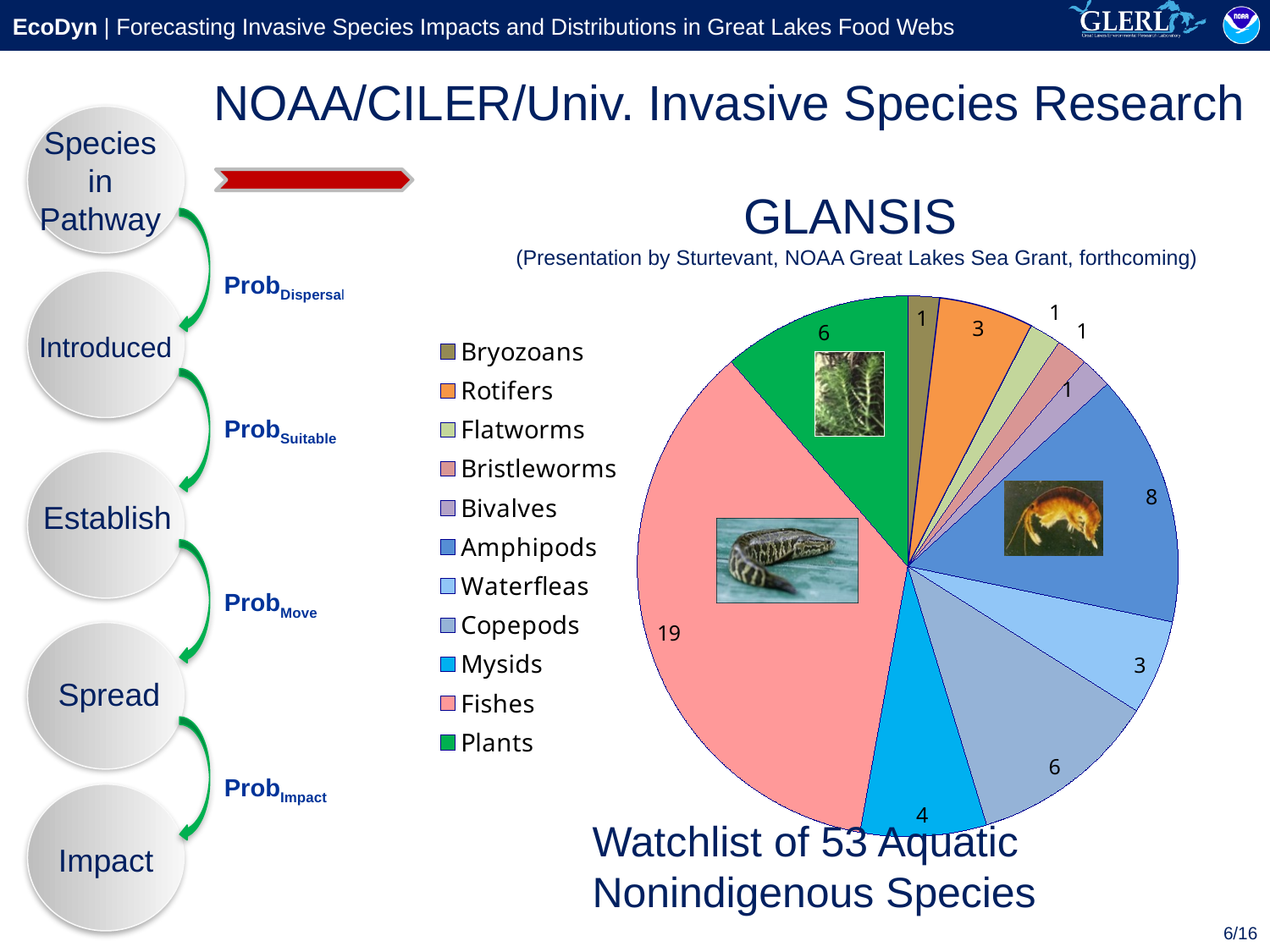
Which legend entry is shown in green in the pie chart? Plants What is the value for Amphipods in the pie chart? 8 What is the total number of species represented across all slices of the pie chart? 53 What is the value for Fishes in the pie chart? 19 How many categories does the pie chart's legend list? 11 What type of chart is shown on the slide? pie chart What is the difference between the values for Fishes and Amphipods? 11 What is the value for Mysids in the pie chart? 4 What is the value for Rotifers in the pie chart? 3 Which category has the largest slice in the pie chart? Fishes Which is larger, the value for Amphipods or the value for Copepods? Amphipods What is the value for Plants in the pie chart? 6